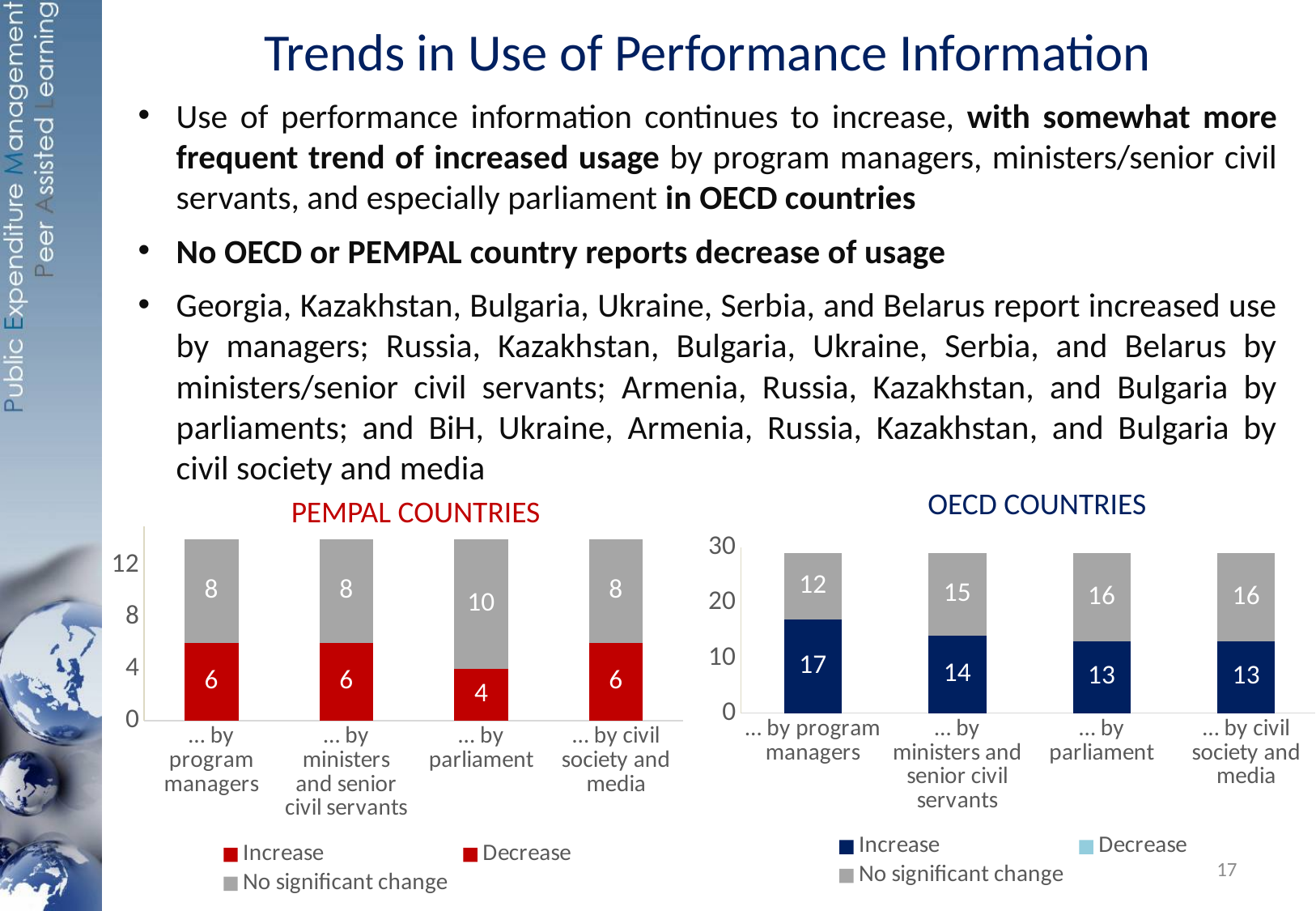
In the OECD COUNTRIES chart, what is the difference between the Increase values for '… by program managers' and '… by parliament'? 4 In the PEMPAL COUNTRIES chart, what is the total of the stacked bar for '… by program managers'? 14 In the OECD COUNTRIES chart, is the Increase value for '… by program managers' larger or smaller than the 'No significant change' value for the same category? larger How many series does the legend of the OECD COUNTRIES chart list? 3 In the OECD COUNTRIES chart, what is the Increase value for '… by program managers'? 17 In the OECD COUNTRIES chart, what is the 'No significant change' value for '… by ministers and senior civil servants'? 15 In the PEMPAL COUNTRIES chart, which category has the lowest Increase value? … by parliament In the OECD COUNTRIES chart, what is the total of the stacked bar for '… by civil society and media'? 29 In the PEMPAL COUNTRIES chart, what is the 'No significant change' value for '… by parliament'? 10 In the OECD COUNTRIES chart, which category has the highest Increase value? … by program managers How many categories are shown on the x axis of the PEMPAL COUNTRIES chart? 4 In the PEMPAL COUNTRIES chart, what is the Increase value for '… by parliament'? 4